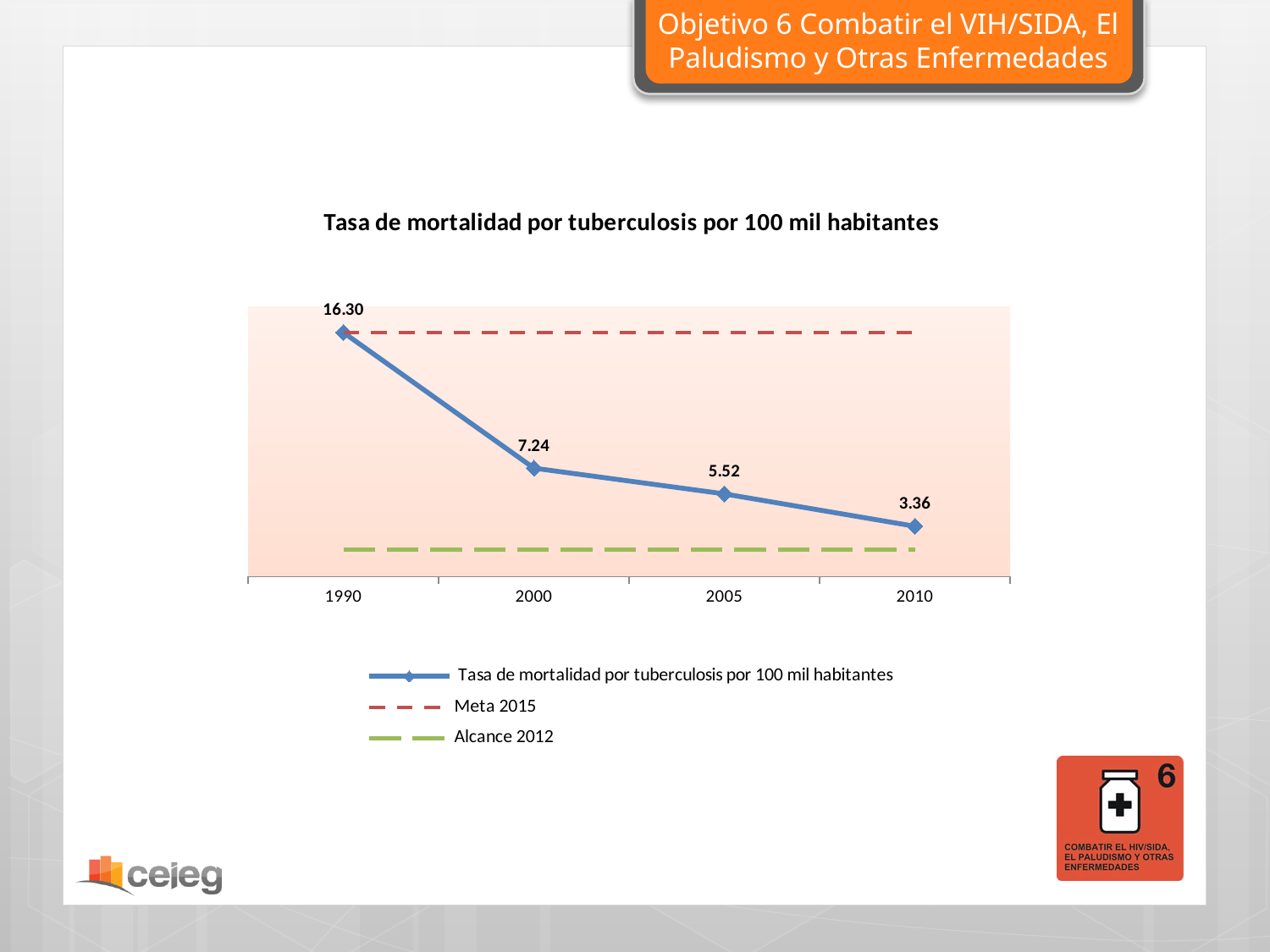
What is the tuberculosis mortality rate per 100 thousand inhabitants in 2000? 7.24 In which year is the tuberculosis mortality rate highest? 1990 By how much did the tuberculosis mortality rate fall between 1990 and 2000? 9.06 In which year is the tuberculosis mortality rate lowest? 2010 How many years are plotted on the x axis of the chart? 4 Does the tuberculosis mortality rate rise or fall from 1990 to 2010? fall What is the tuberculosis mortality rate per 100 thousand inhabitants in 2010? 3.36 What is the tuberculosis mortality rate per 100 thousand inhabitants in 1990? 16.30 How many series does the legend list? 3 Which year has a higher tuberculosis mortality rate, 2000 or 2005? 2000 What is the difference between the tuberculosis mortality rate in 1990 and in 2010? 12.94 What is the tuberculosis mortality rate per 100 thousand inhabitants in 2005? 5.52